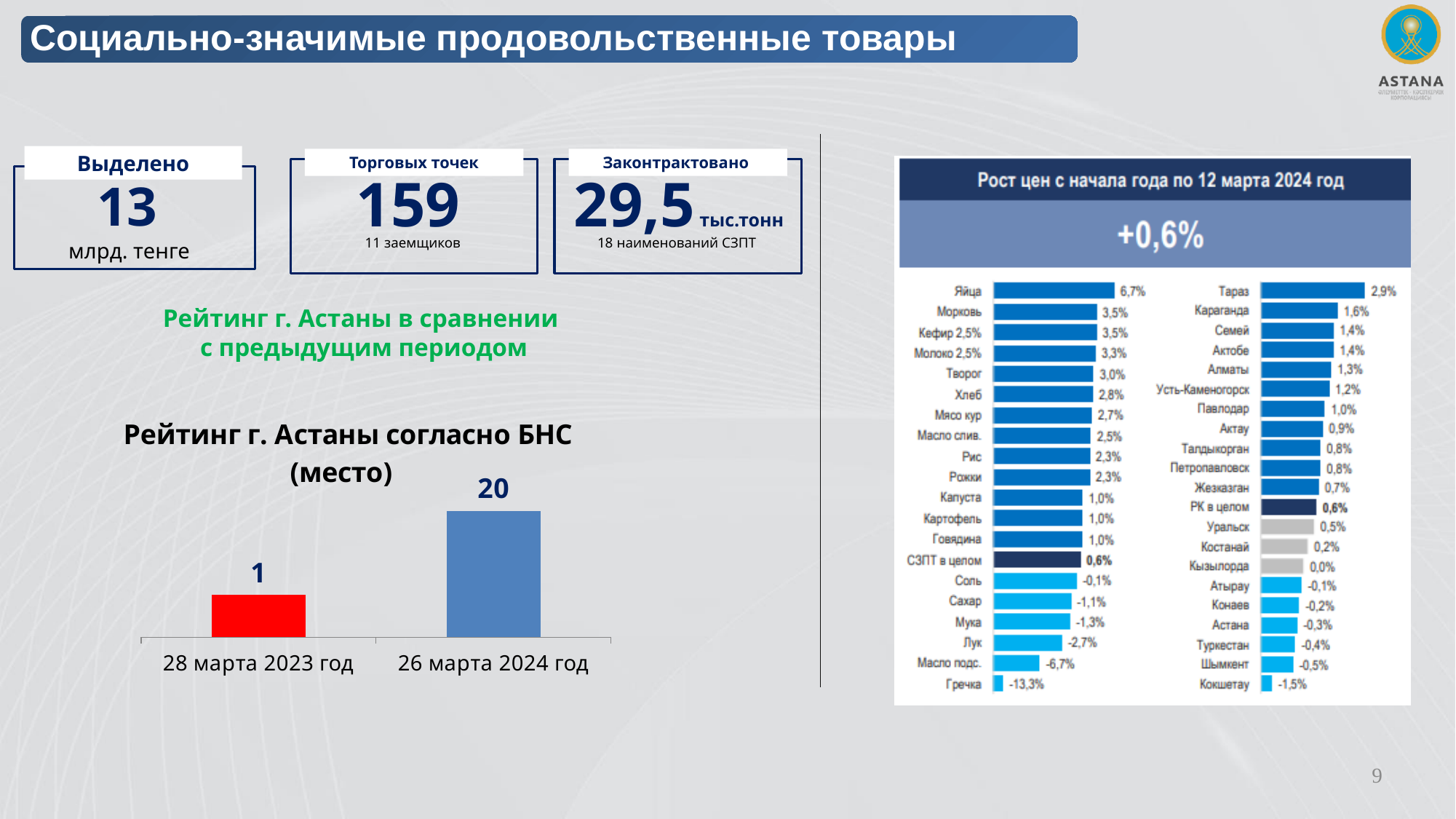
In the chart 'Рейтинг г. Астаны согласно БНС (место)', what colour is the bar for 28 марта 2023 год? red In the chart 'Рейтинг г. Астаны согласно БНС (место)', what is the value for 26 марта 2024 год? 20 In the chart 'Рост цен с начала года по 12 марта 2024 год', what is the value for Астана? -0,3% In the chart 'Рост цен с начала года по 12 марта 2024 год', which city has the highest value? Тараз In the chart 'Рост цен с начала года по 12 марта 2024 год', which is larger: the value for Морковь or the value for Хлеб? Морковь In the chart 'Рейтинг г. Астаны согласно БНС (место)', what is the value for 28 марта 2023 год? 1 In the chart 'Рост цен с начала года по 12 марта 2024 год', what is the value for Яйца? 6,7% In the chart 'Рост цен с начала года по 12 марта 2024 год', what is the value for Гречка? -13,3% In the chart 'Рейтинг г. Астаны согласно БНС (место)', what is the difference between the values for 26 марта 2024 год and 28 марта 2023 год? 19 In the chart 'Рейтинг г. Астаны согласно БНС (место)', how many categories are shown on the x axis? 2 What kind of chart is 'Рейтинг г. Астаны согласно БНС (место)'? bar chart In the chart 'Рост цен с начала года по 12 марта 2024 год', which product has the lowest value? Гречка